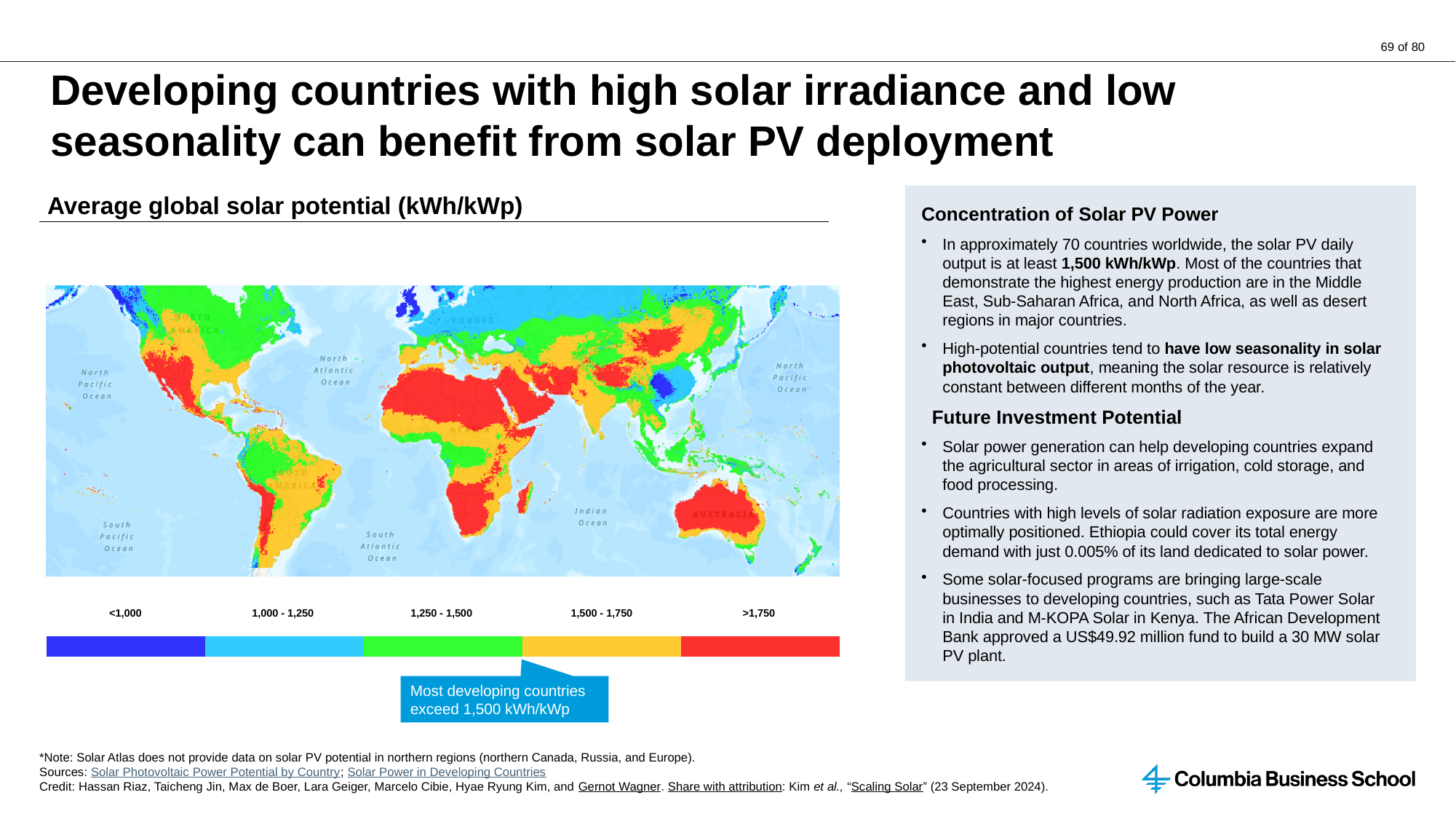
Which colour in the map legend represents the >1,750 kWh/kWp range? Red Which value range in the map legend is shown in dark blue? <1,000 What kind of chart is shown on the left of the slide? A map (heat map of solar potential) How many value ranges does the colour legend below the map list? 5 Which value range in the map legend is shown in green? 1,250 - 1,500 What is the title of the map chart on the slide? Average global solar potential (kWh/kWp) According to the callout below the map legend, what value do most developing countries exceed? 1,500 kWh/kWp What is the lowest value range shown in the map's colour legend? <1,000 What unit is used for the solar potential values in the map chart? kWh/kWp What is the highest value range shown in the map's colour legend? >1,750 Which value range in the map legend is shown in yellow? 1,500 - 1,750